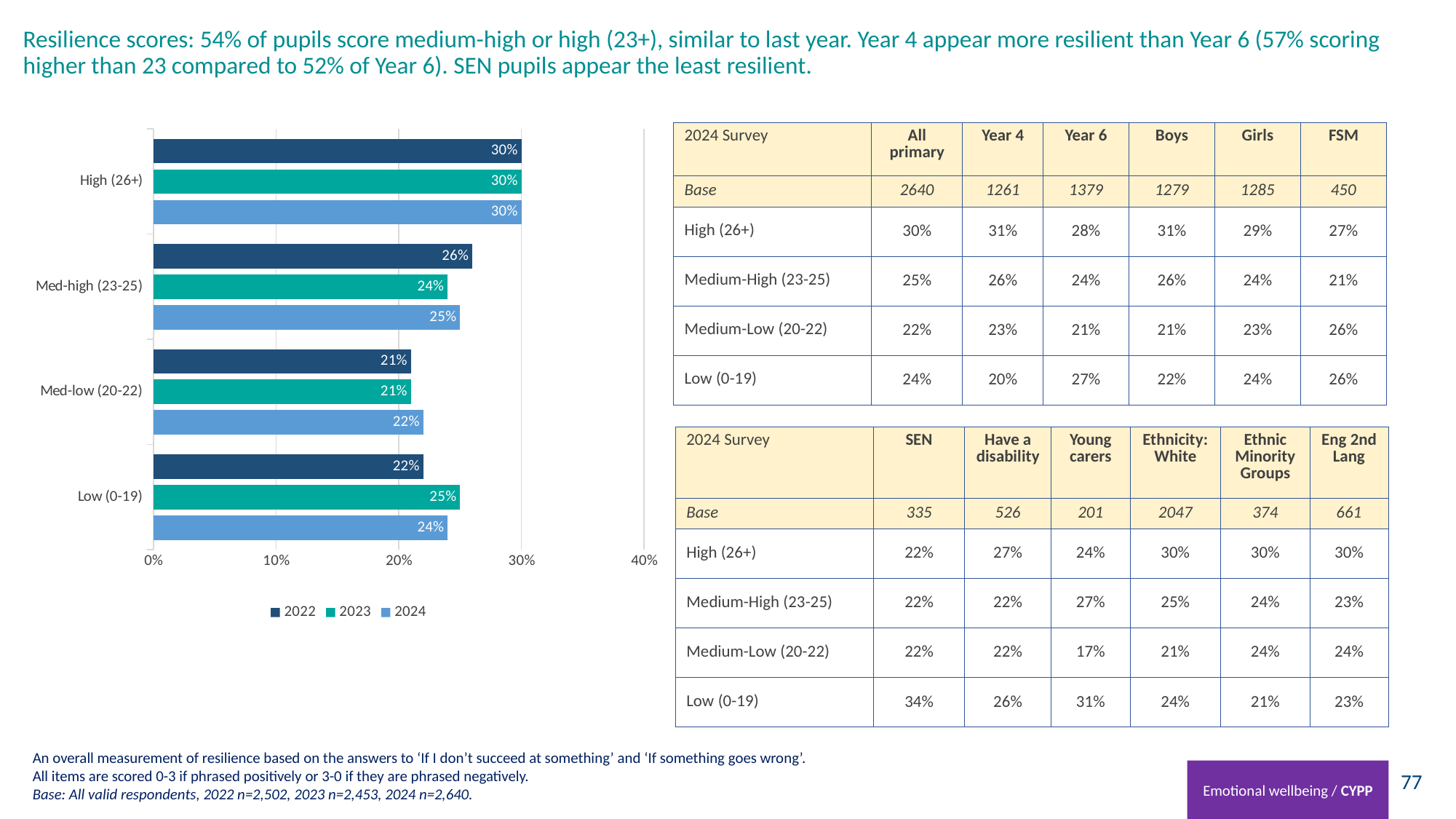
What kind of chart is shown on the slide? bar chart What is the 2022 value for Med-low (20-22) on the chart? 21% What is the difference between the 2022 and 2023 values for Low (0-19)? 3% Is the 2024 value for High (26+) greater or less than 20%? greater How many series does the chart legend list? 3 Which category has the highest 2024 value on the chart? High (26+) Which years are listed in the chart legend? 2022, 2023, 2024 Which is larger on the chart: the 2022 value for Med-high (23-25) or the 2023 value for Med-high (23-25)? 2022 Which category has the lowest 2022 value on the chart? Med-low (20-22) What is the 2024 value for Med-high (23-25) on the chart? 25% How many score categories are plotted on the chart? 4 What is the 2023 value for Low (0-19) on the chart? 25%